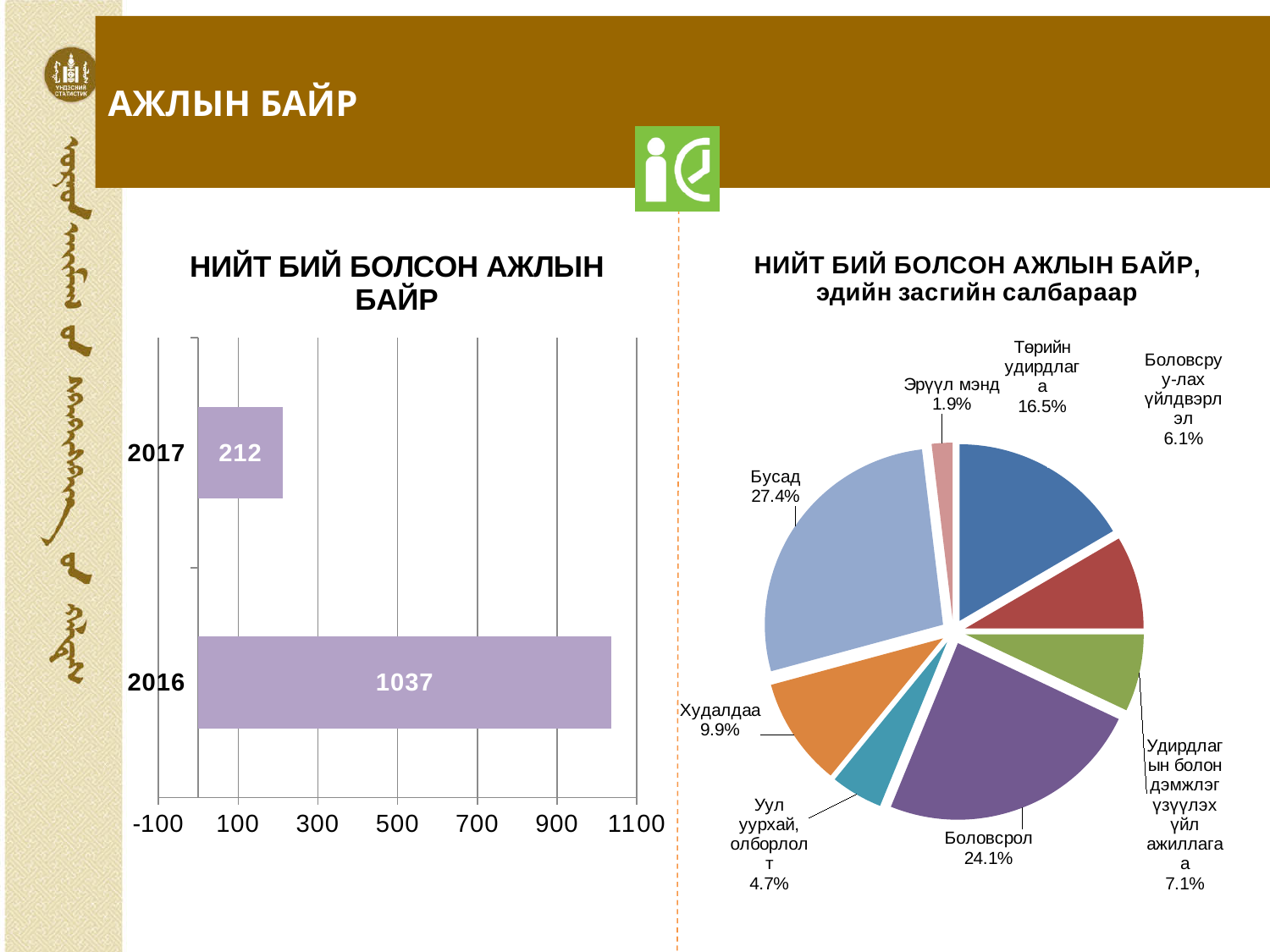
In the pie chart 'НИЙТ БИЙ БОЛСОН АЖЛЫН БАЙР, эдийн засгийн салбараар', which sector has the largest share? Бусад In the bar chart 'НИЙТ БИЙ БОЛСОН АЖЛЫН БАЙР', how many years are shown? 2 In the pie chart 'НИЙТ БИЙ БОЛСОН АЖЛЫН БАЙР, эдийн засгийн салбараар', which sector has the smallest share? Эрүүл мэнд In the pie chart 'НИЙТ БИЙ БОЛСОН АЖЛЫН БАЙР, эдийн засгийн салбараар', what share does Эрүүл мэнд have? 1.9% What kind of chart is the left chart 'НИЙТ БИЙ БОЛСОН АЖЛЫН БАЙР'? Bar chart In the bar chart 'НИЙТ БИЙ БОЛСОН АЖЛЫН БАЙР', what is the value for 2017? 212 In the bar chart 'НИЙТ БИЙ БОЛСОН АЖЛЫН БАЙР', which year has the higher value? 2016 In the bar chart 'НИЙТ БИЙ БОЛСОН АЖЛЫН БАЙР', what is the difference between the 2016 and 2017 values? 825 In the pie chart 'НИЙТ БИЙ БОЛСОН АЖЛЫН БАЙР, эдийн засгийн салбараар', how many slices are there? 8 In the pie chart 'НИЙТ БИЙ БОЛСОН АЖЛЫН БАЙР, эдийн засгийн салбараар', which is larger: Худалдаа or Төрийн удирдлага? Төрийн удирдлага In the bar chart 'НИЙТ БИЙ БОЛСОН АЖЛЫН БАЙР', what is the value for 2016? 1037 In the pie chart 'НИЙТ БИЙ БОЛСОН АЖЛЫН БАЙР, эдийн засгийн салбараар', what share does Боловсрол have? 24.1%